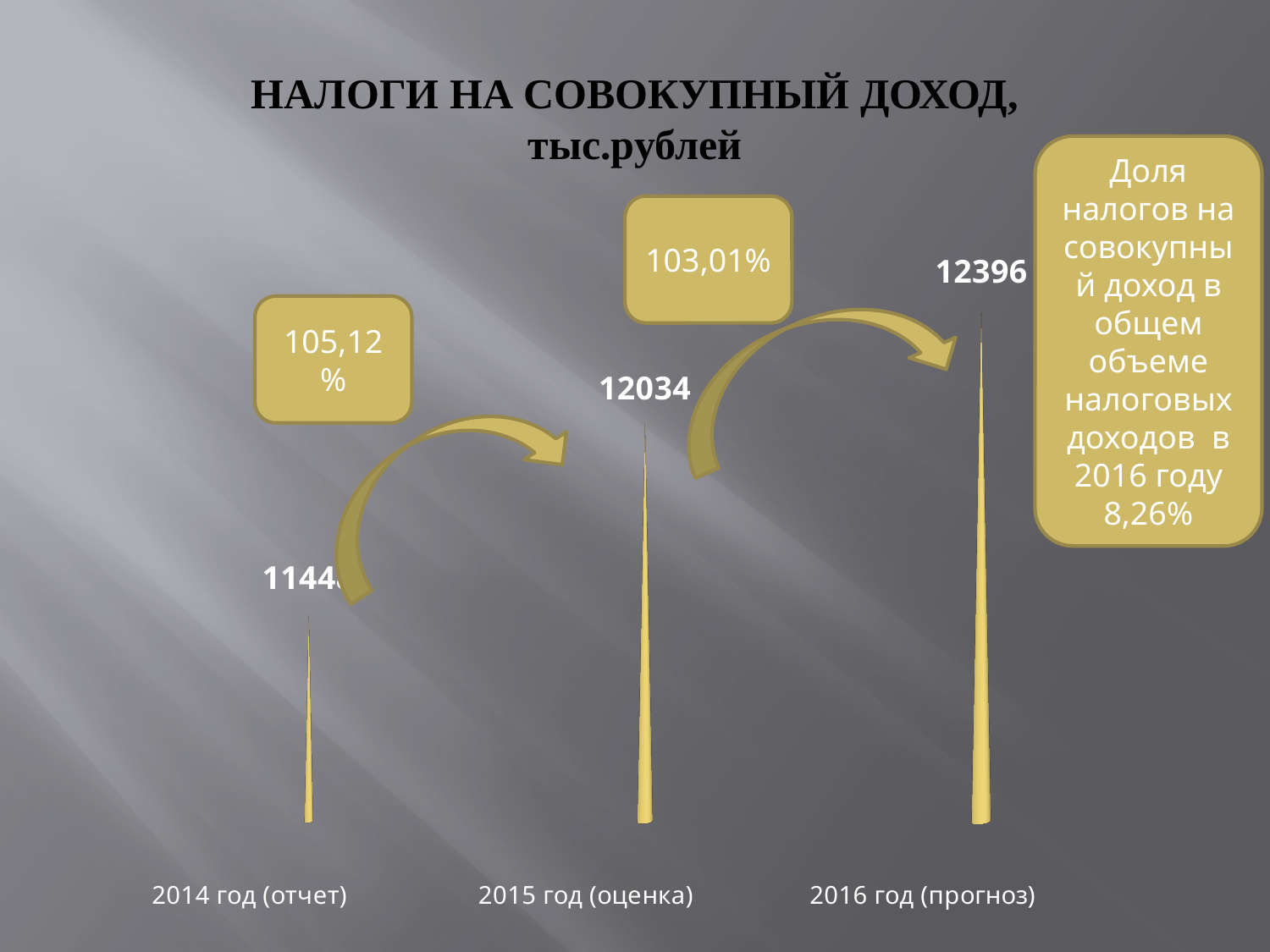
What is the title of the chart? НАЛОГИ НА СОВОКУПНЫЙ ДОХОД, тыс.рублей Which year has the lowest value? 2014 год (отчет) Which is larger, the value for 2015 год (оценка) or 2014 год (отчет)? 2015 год (оценка) What growth percentage is shown on the arrow from 2015 to 2016? 103,01% What is the value for 2015 год (оценка)? 12034 What kind of chart is shown on the slide? Bar chart How many categories are shown on the chart? 3 What is the value for 2016 год (прогноз)? 12396 What is the difference between the values for 2016 год (прогноз) and 2015 год (оценка)? 362 Do the values rise or fall from 2014 to 2016? Rise Which year has the highest value? 2016 год (прогноз)